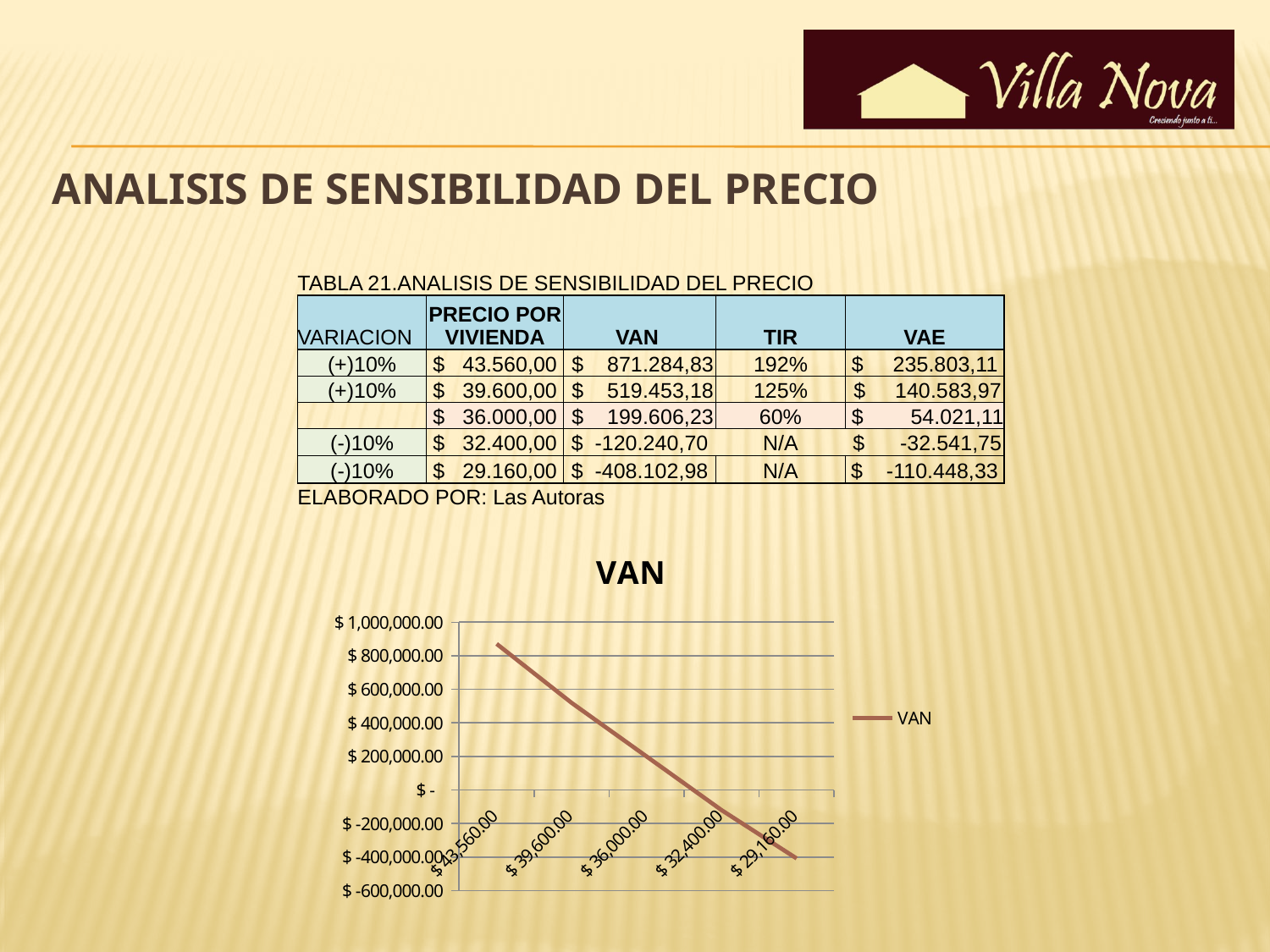
Which has the larger VAN value, $ 39,600.00 or $ 32,400.00? $ 39,600.00 Is the VAN value for $ 29,160.00 greater or less than $ -200,000.00? less Is the VAN value for $ 43,560.00 greater or less than $ 800,000.00? greater How many data points are plotted on the VAN chart? 5 Which price on the x axis has the lowest VAN value? $ 29,160.00 How many series does the legend of the VAN chart list? 1 Which price on the x axis has the highest VAN value? $ 43,560.00 Is the VAN value for $ 36,000.00 greater or less than $ 400,000.00? less What is the title of the chart on the slide? VAN What kind of chart is the VAN chart? line chart Do the VAN values rise or fall moving left to right along the x axis? fall